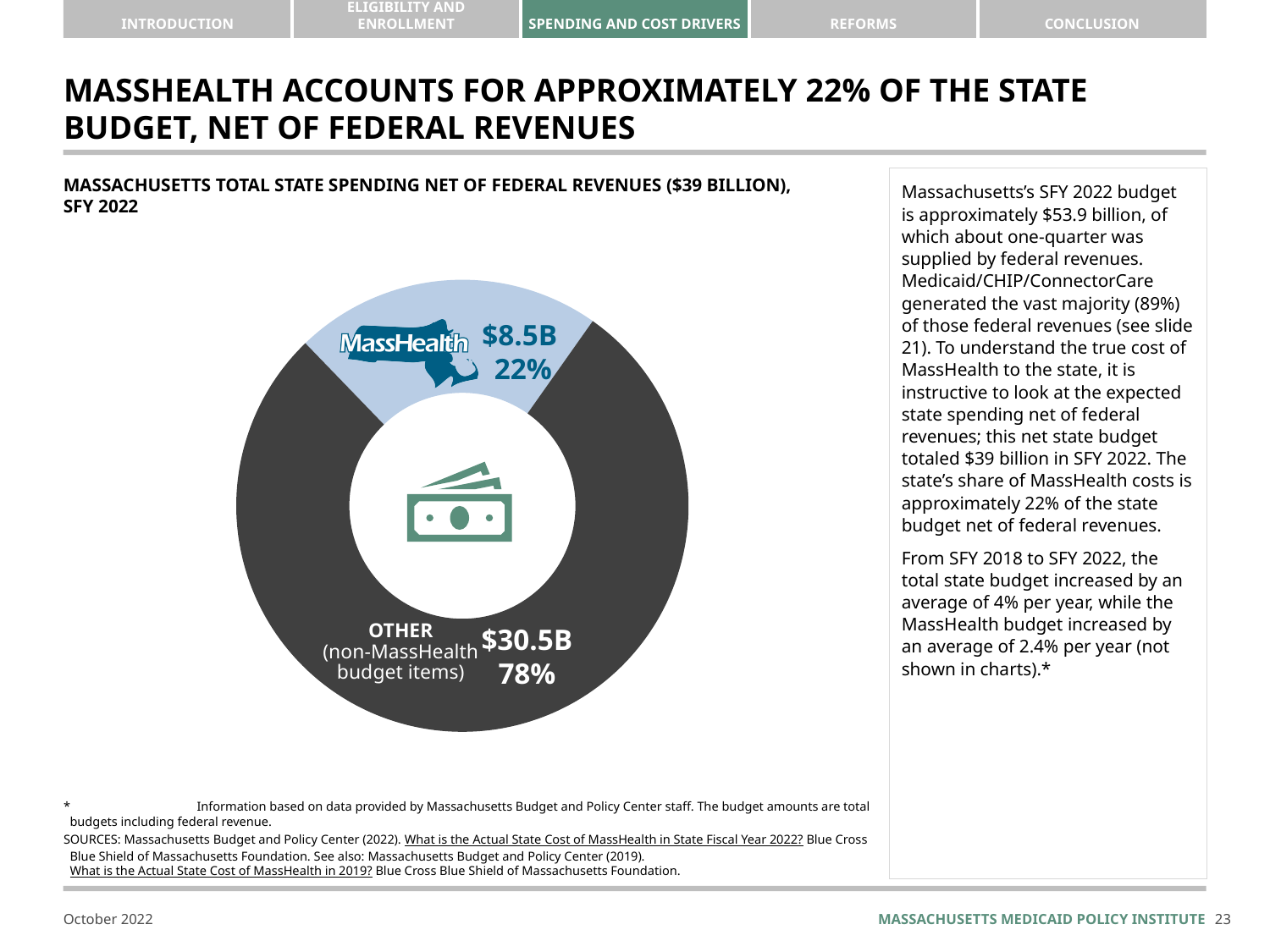
Which slice is the largest? Other (non-MassHealth budget items) How many slices does the chart have? 2 What percentage of the chart does MassHealth represent? 22% What is the dollar value shown for MassHealth? $8.5B What is the title of the chart? Massachusetts Total State Spending Net of Federal Revenues ($39 Billion), SFY 2022 What percentage of the chart does Other (non-MassHealth budget items) represent? 78% What kind of chart is shown on the slide? Pie chart (donut) Which slice is the smallest? MassHealth Which is larger, the MassHealth slice or the Other slice? Other What is the difference in dollars between the Other slice and the MassHealth slice? $22B What is the dollar value shown for Other (non-MassHealth budget items)? $30.5B What is the total dollar amount of the two slices combined? $39B